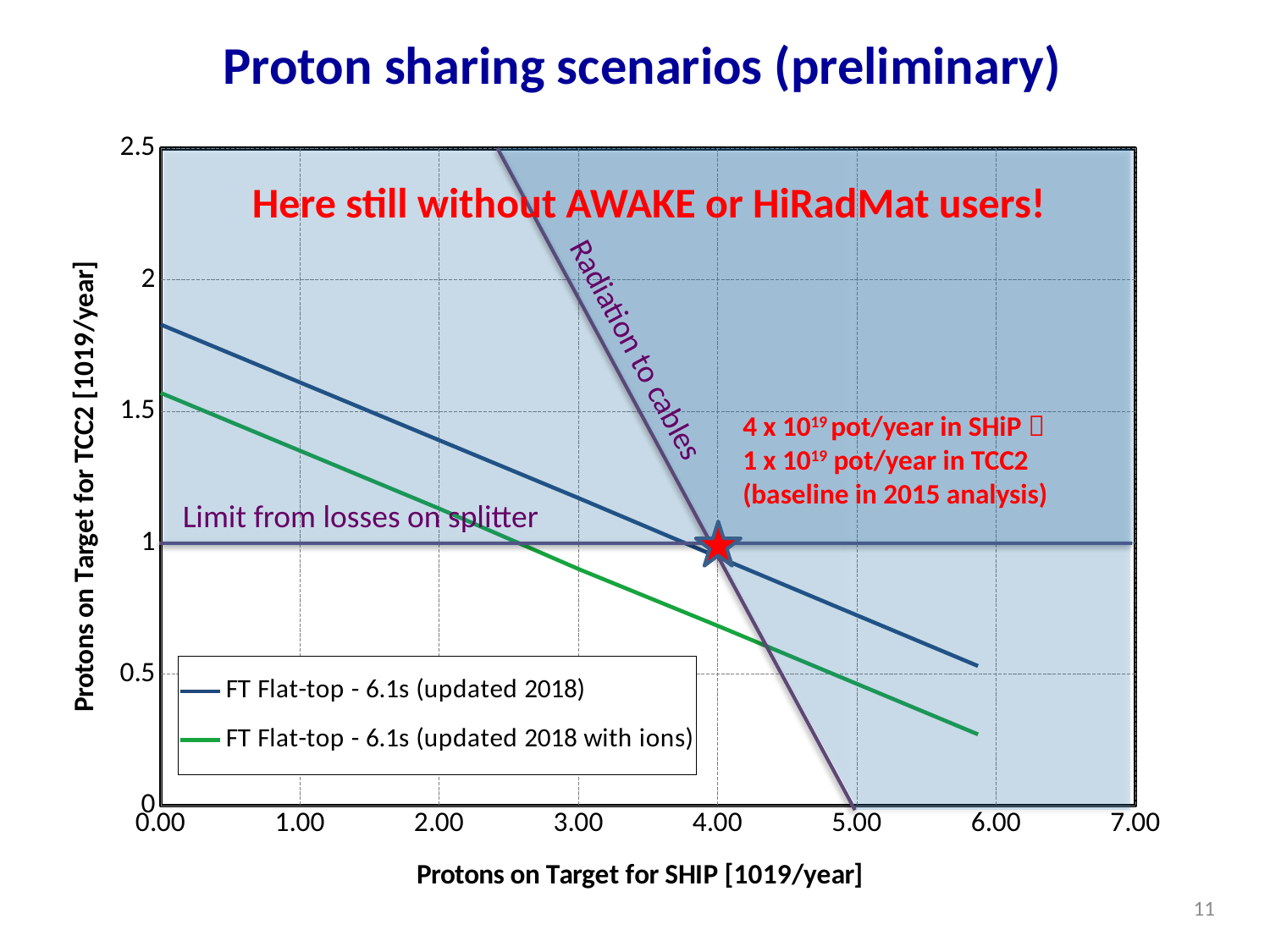
Do the values of the 'FT Flat-top - 6.1s (updated 2018 with ions)' line rise or fall along the x axis? fall At 2.00 on the x axis, which line is higher: 'FT Flat-top - 6.1s (updated 2018)' or 'FT Flat-top - 6.1s (updated 2018 with ions)'? FT Flat-top - 6.1s (updated 2018) Do the values of the 'FT Flat-top - 6.1s (updated 2018)' line rise or fall as Protons on Target for SHIP increases? fall Is the value of the 'FT Flat-top - 6.1s (updated 2018 with ions)' line at 0.00 on the x axis greater or less than 2? less What is the first entry in the chart legend? FT Flat-top - 6.1s (updated 2018) Is the value of the 'FT Flat-top - 6.1s (updated 2018)' line at 5.00 on the x axis greater or less than 1? less Is the value of the 'FT Flat-top - 6.1s (updated 2018)' line at 0.00 on the x axis greater or less than 1.5? greater At what x-axis value is the red star marker placed? 4.00 At what y-axis value is the horizontal 'Limit from losses on splitter' line drawn? 1 What is the title of the x axis? Protons on Target for SHIP [1019/year] What kind of chart is shown on the slide? line chart How many series does the legend list? 2